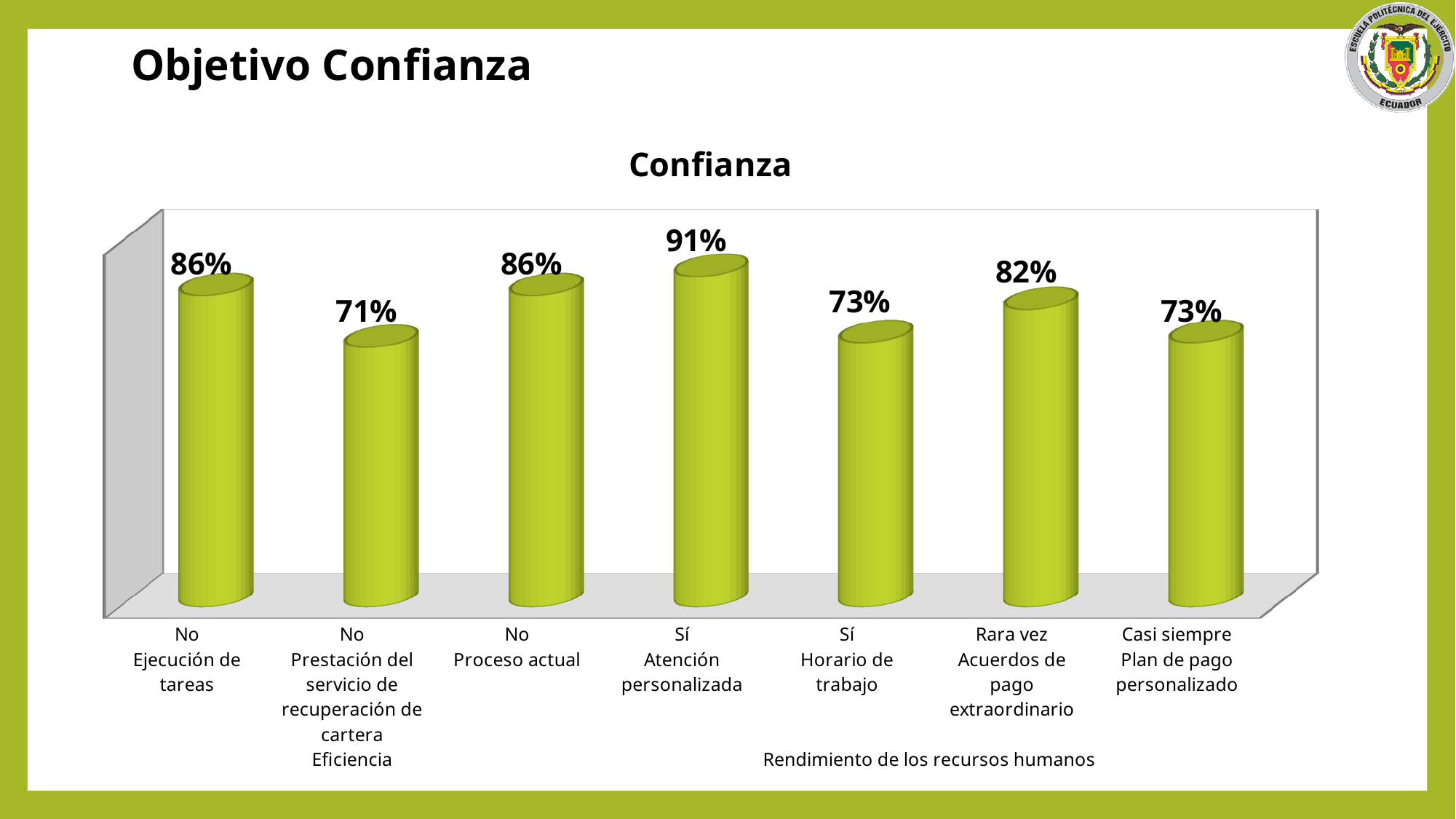
What is the difference between the values for 'Atención personalizada' and 'Prestación del servicio de recuperación de cartera'? 20% How many bars are plotted in the Confianza chart? 7 Which category has the highest value in the Confianza chart? Atención personalizada What is the value shown for 'Atención personalizada' in the Confianza chart? 91% What value is labelled on the bar for 'Acuerdos de pago extraordinario'? 82% What is the value shown for 'Prestación del servicio de recuperación de cartera'? 71% Which category has the lowest value in the Confianza chart? Prestación del servicio de recuperación de cartera What is the title of the chart on the slide? Confianza Which is larger, the value for 'Ejecución de tareas' or the value for 'Acuerdos de pago extraordinario'? Ejecución de tareas What kind of chart is shown on the slide? Bar chart What is the difference between the values for 'Proceso actual' and 'Plan de pago personalizado'? 13% What is the value for 'Horario de trabajo'? 73%